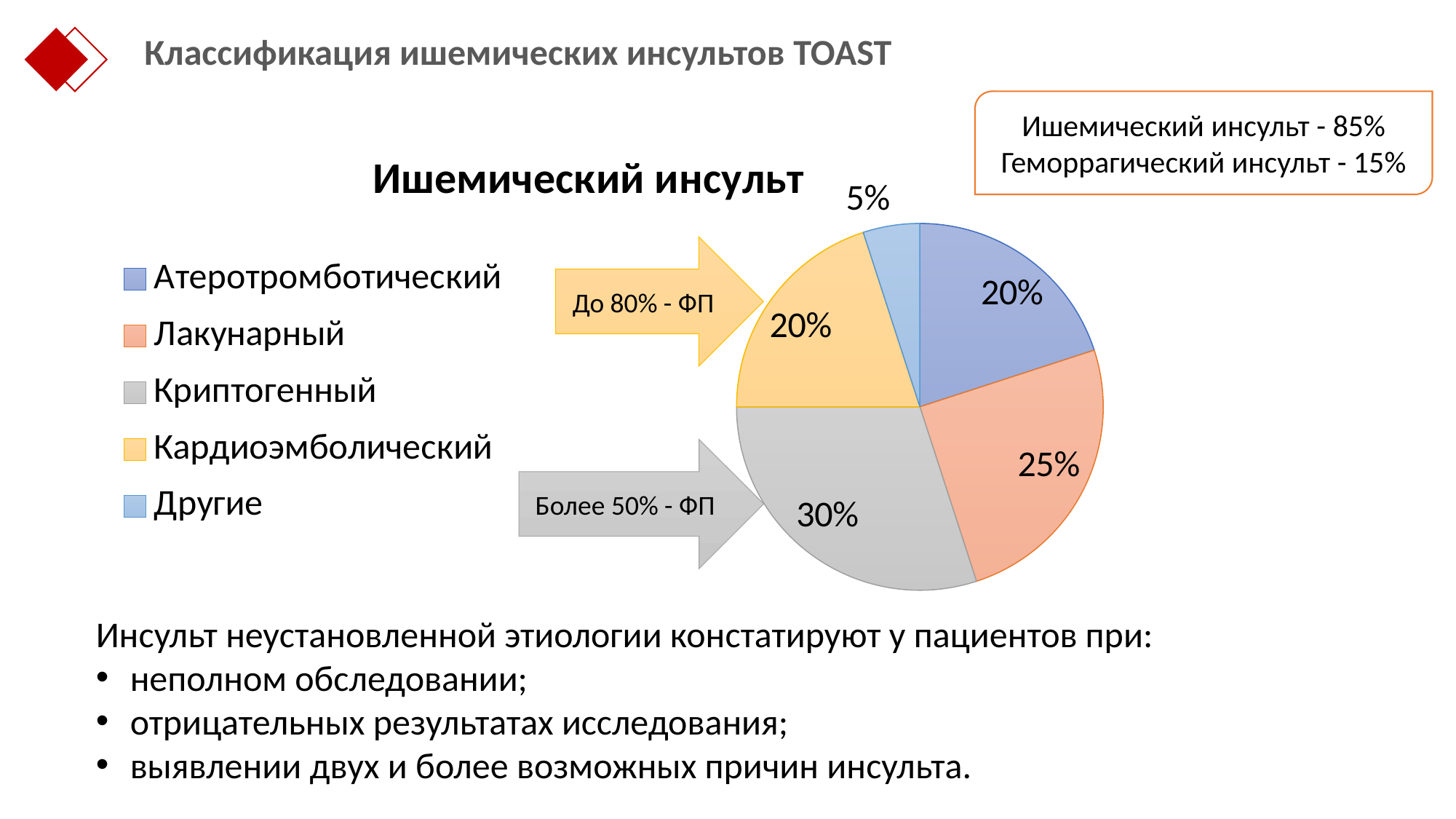
Which legend entry is shown in grey? Криптогенный What share of the pie does Криптогенный have? 30% Which is larger, the share of Лакунарный or the share of Кардиоэмболический? Лакунарный What kind of chart is shown on the slide? Pie chart How many slices does the pie chart have? 5 Which category has the largest slice of the pie? Криптогенный What is the title of the pie chart? Ишемический инсульт What share of the pie does Лакунарный have? 25% Which category has the smallest slice of the pie? Другие What is the difference between the shares of Криптогенный and Лакунарный? 5% What share of the pie does Атеротромботический have? 20% What share of the pie does Другие have? 5%